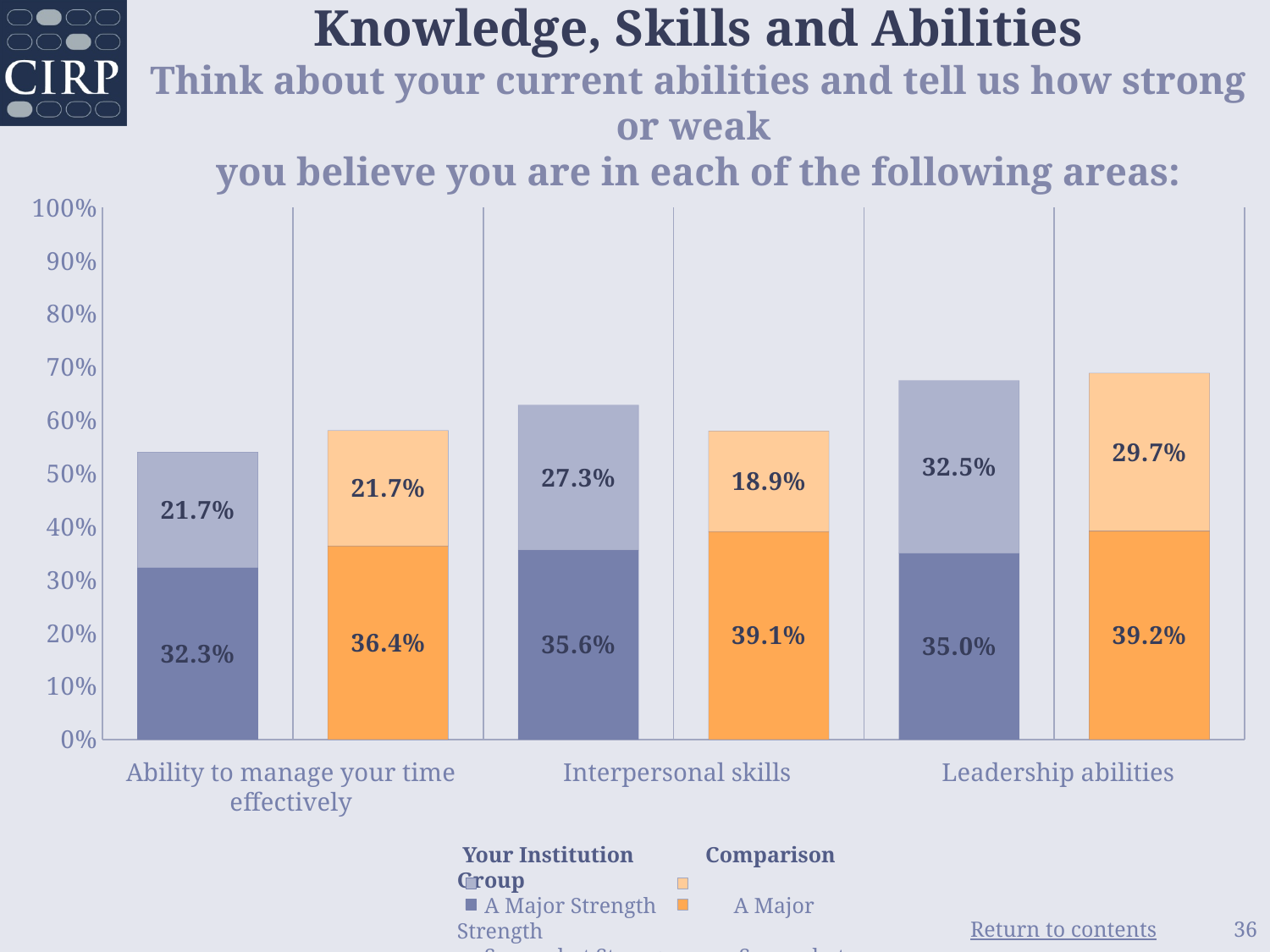
For Interpersonal skills, which is larger: the 'A Major Strength' value for Your Institution or for the Comparison Group? Comparison Group What is the value of the top (lighter) segment of the Your Institution bar for Leadership abilities? 32.5% What is the 'A Major Strength' value for Your Institution for Interpersonal skills? 35.6% Which category has the lowest 'A Major Strength' value for the Comparison Group? Ability to manage your time effectively What type of chart is shown on the slide? stacked bar chart What is the difference between the Comparison Group and Your Institution 'A Major Strength' values for Ability to manage your time effectively? 4.1% What is the total height of the Your Institution stacked bar for Leadership abilities? 67.5% What is the 'A Major Strength' value for the Comparison Group for Leadership abilities? 39.2% How many categories are shown along the x axis? 3 Which category has the highest 'A Major Strength' value for Your Institution? Interpersonal skills What is the value of the top (lighter) segment of the Comparison Group bar for Interpersonal skills? 18.9% Is the total of the Comparison Group stacked bar for Ability to manage your time effectively greater or less than 60%? less